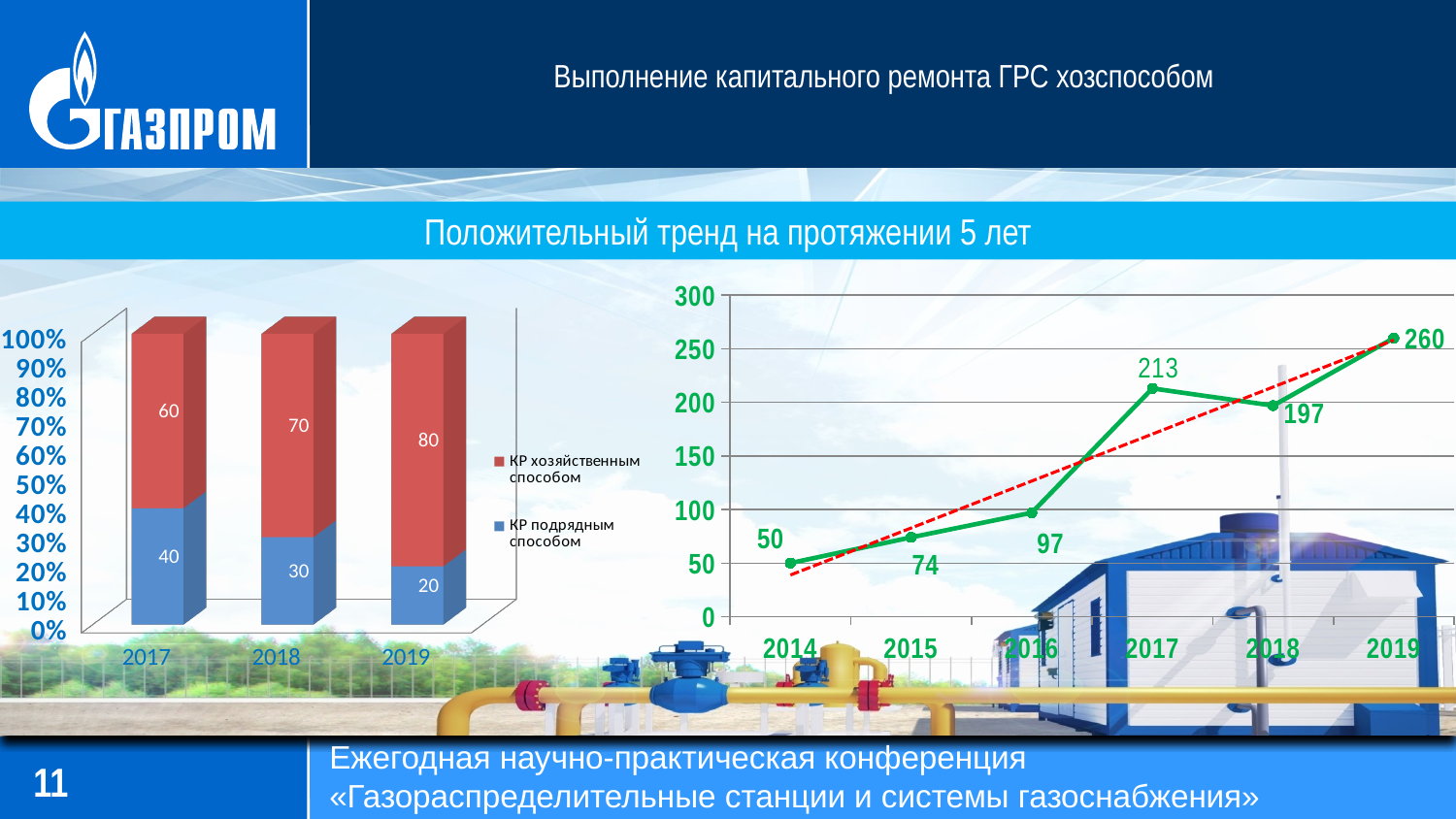
In the right line chart, what is the value for 2014? 50 In the left stacked bar chart, does the value of "КР хозяйственным способом" rise or fall from 2017 to 2019? rise In the right line chart, which is larger, the value for 2017 or the value for 2018? 2017 In the left stacked bar chart, how many series does the legend list? 2 In the left stacked bar chart, what is the value of "КР подрядным способом" for 2017? 40 In the right line chart, what is the difference between the values for 2019 and 2018? 63 In the right line chart, which year has the highest value? 2019 In the right line chart, what is the value for 2017? 213 In the right line chart, how many years are plotted on the x axis? 6 In the left stacked bar chart, what is the value of "КР хозяйственным способом" for 2019? 80 In the left stacked bar chart, which year has the lowest value for "КР подрядным способом"? 2019 In the left stacked bar chart, what is the value of "КР подрядным способом" for 2018? 30